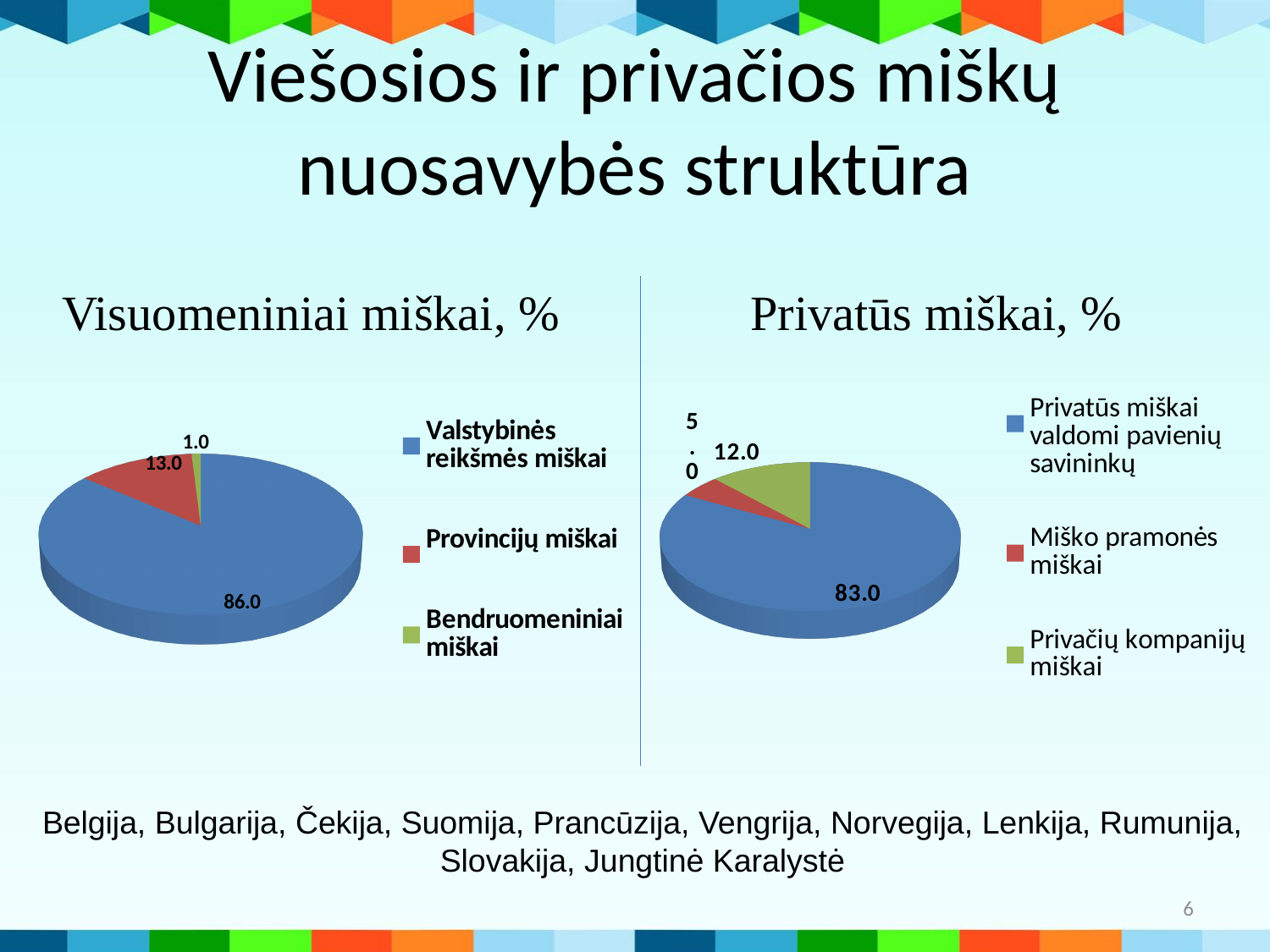
In the 'Privatūs miškai, %' chart, which category has the smallest slice? Miško pramonės miškai In the 'Visuomeniniai miškai, %' chart, what is the value for Provincijų miškai? 13.0 How many categories does the 'Privatūs miškai, %' chart show? 3 What type of chart is the 'Visuomeniniai miškai, %' chart? Pie chart In the 'Visuomeniniai miškai, %' chart, what is the value for Valstybinės reikšmės miškai? 86.0 In the 'Privatūs miškai, %' chart, what is the value for Privatūs miškai valdomi pavienių savininkų? 83.0 In the 'Privatūs miškai, %' chart, what is the value for Privačių kompanijų miškai? 12.0 In the 'Privatūs miškai, %' chart, what is the value for Miško pramonės miškai? 5.0 In the 'Privatūs miškai, %' chart, which is larger: Privačių kompanijų miškai or Miško pramonės miškai? Privačių kompanijų miškai In the 'Visuomeniniai miškai, %' chart, what is the difference between the values for Valstybinės reikšmės miškai and Provincijų miškai? 73.0 In the 'Visuomeniniai miškai, %' chart, what is the value for Bendruomeniniai miškai? 1.0 In the 'Visuomeniniai miškai, %' chart, which category has the largest slice? Valstybinės reikšmės miškai